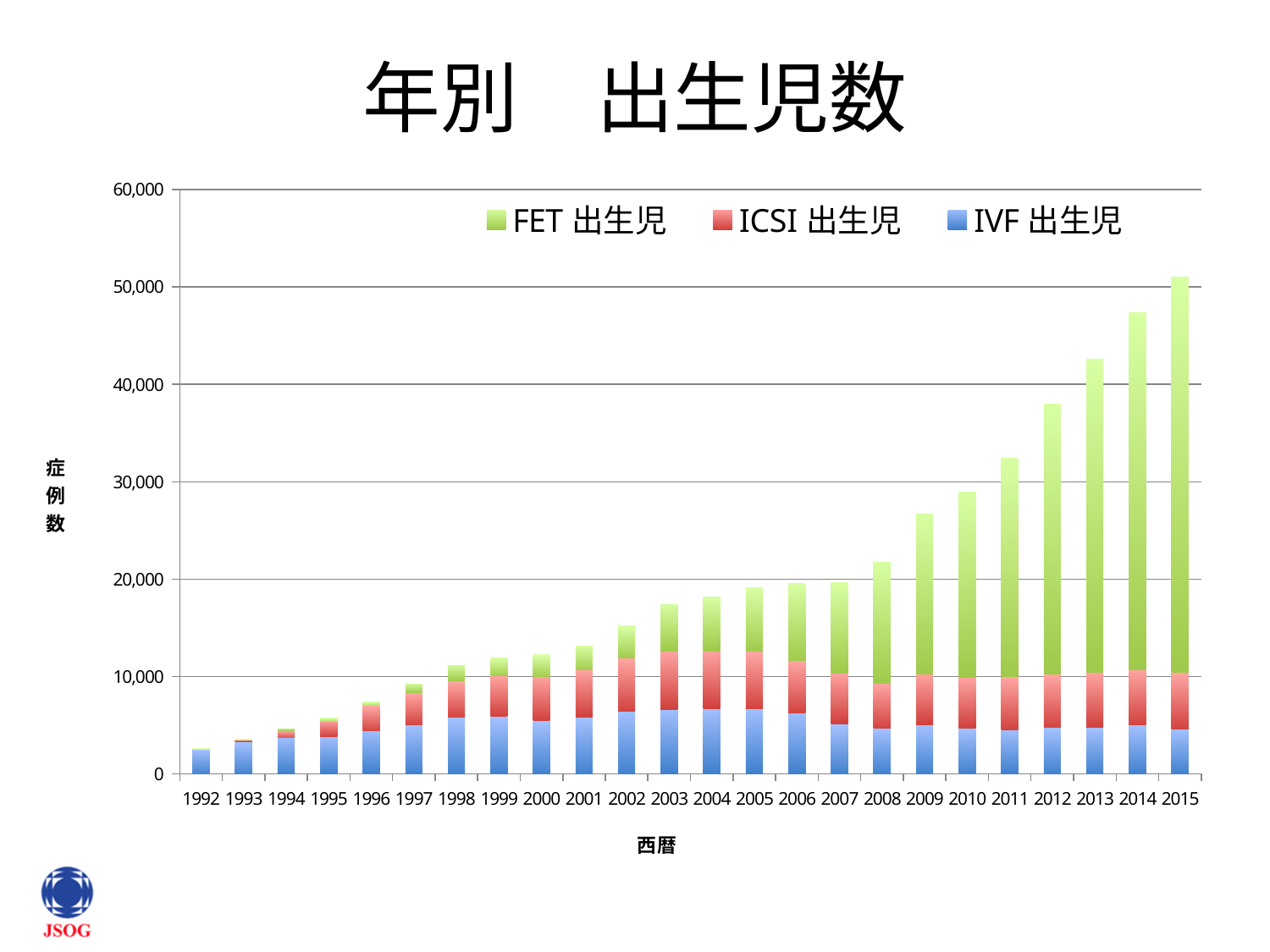
How many series does the chart's legend list? 3 Is the total value for 1997 greater or less than 10,000? less Which year has the tallest stacked bar in the chart? 2015 Is the total value for 2015 greater or less than 40,000? greater Which series is shown in green in the chart's legend? FET 出生児 Is the total value for 2008 greater or less than 20,000? greater Which year has the larger total bar, 2013 or 2014? 2014 Do the total bar heights generally rise or fall from 1992 to 2015? rise What kind of chart is shown on the slide? stacked bar chart Which year has the shortest stacked bar in the chart? 1992 How many years are shown along the x axis of the chart? 24